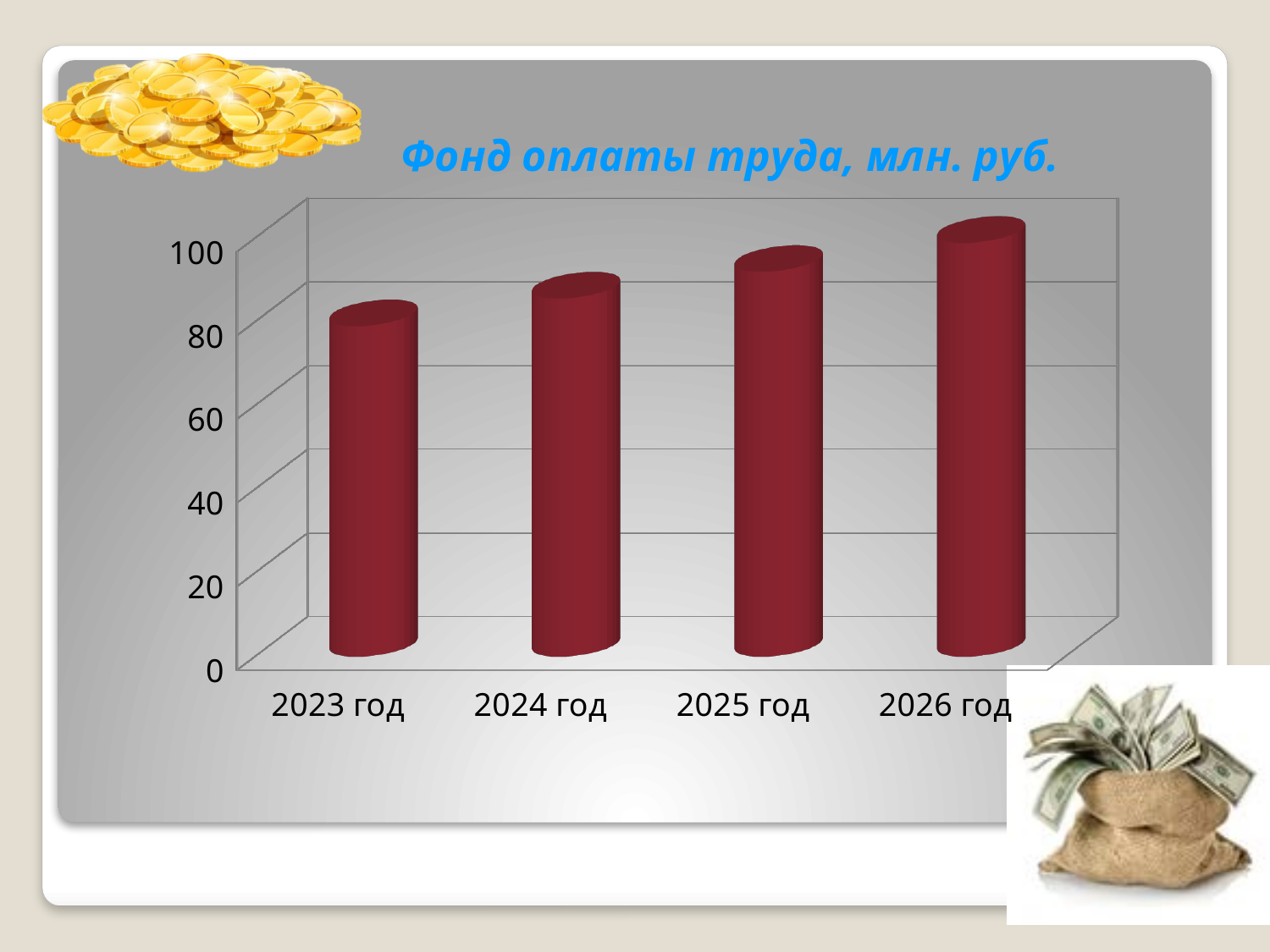
Which year has the highest value in the chart? 2026 год Is the value for 2024 год greater or less than 60? greater Which year has the lowest value in the chart? 2023 год Which is larger, the value for 2025 год or the value for 2024 год? 2025 год What is the title of the chart? Фонд оплаты труда, млн. руб. Is the value for 2023 год greater or less than 100? less How many years are shown on the x axis of the chart? 4 Which is larger, the value for 2026 год or the value for 2023 год? 2026 год What kind of chart is shown on the slide? bar chart Do the values rise or fall from 2023 год to 2026 год? rise Is the value for 2026 год greater or less than 80? greater What colour are the bars in the chart? dark red